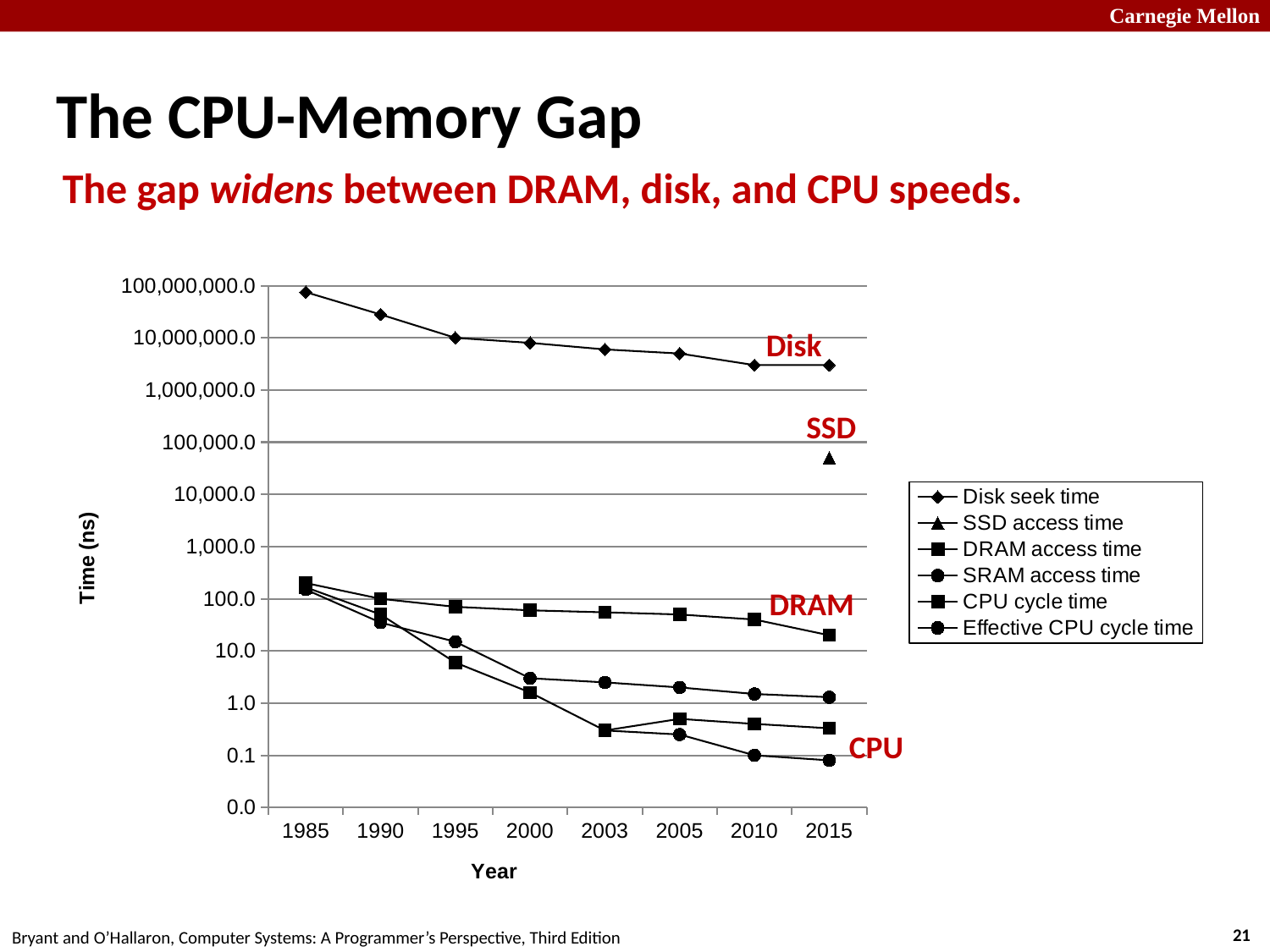
Is the Effective CPU cycle time value for 2015 greater or less than 1.0? less Is the Disk seek time value for 2015 greater or less than 1,000,000? greater How many years are marked on the x axis? 8 Does the Disk seek time rise or fall from 1985 to 2015? fall Which series has the lowest value in 2015? Effective CPU cycle time Is the Disk seek time value for 1985 greater or less than 10,000,000? greater How many series does the legend list? 6 What is the label on the y axis? Time (ns) Which series has the highest value in 2015? Disk seek time What kind of chart is shown on the slide? line chart